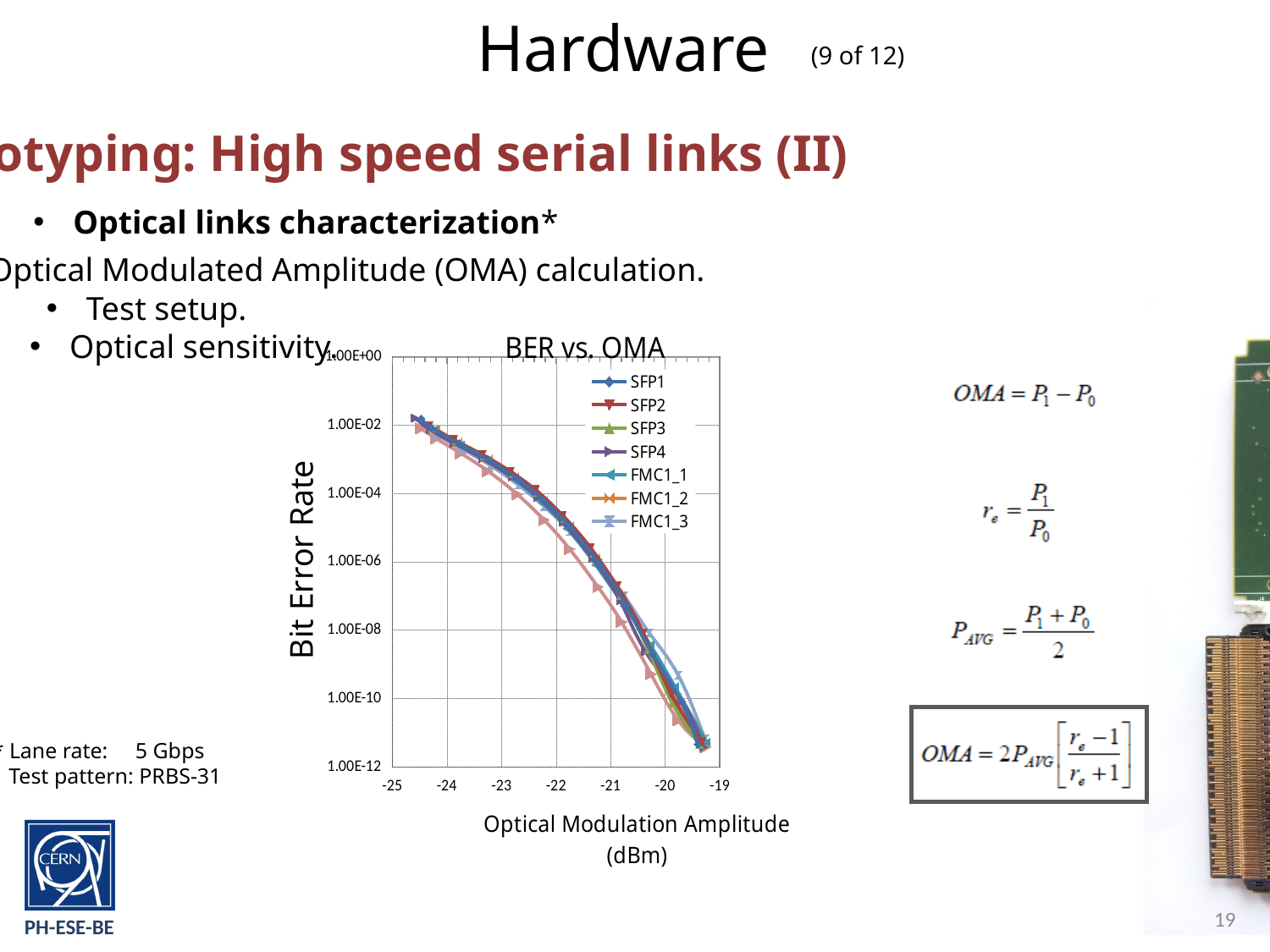
In the 'BER vs. OMA' chart, is the Bit Error Rate for SFP3 at an OMA of -19.5 dBm greater or less than 1.00E-08? less In the 'BER vs. OMA' chart, is the Bit Error Rate for FMC1_1 at an OMA of -24 dBm greater or less than 1.00E-04? greater In the 'BER vs. OMA' chart, does the Bit Error Rate rise or fall as the Optical Modulation Amplitude increases from -25 to -19 dBm? fall In the 'BER vs. OMA' chart, is the Bit Error Rate for SFP2 at an OMA of -22 dBm greater or less than 1.00E-08? greater How many series does the legend of the 'BER vs. OMA' chart list? 7 What is the title of the chart on the slide? BER vs. OMA What is the label of the y axis of the 'BER vs. OMA' chart? Bit Error Rate What kind of chart is the 'BER vs. OMA' chart? line chart What is the lowest value shown on the x axis of the 'BER vs. OMA' chart? -25 What is the highest value shown on the y axis of the 'BER vs. OMA' chart? 1.00E+00